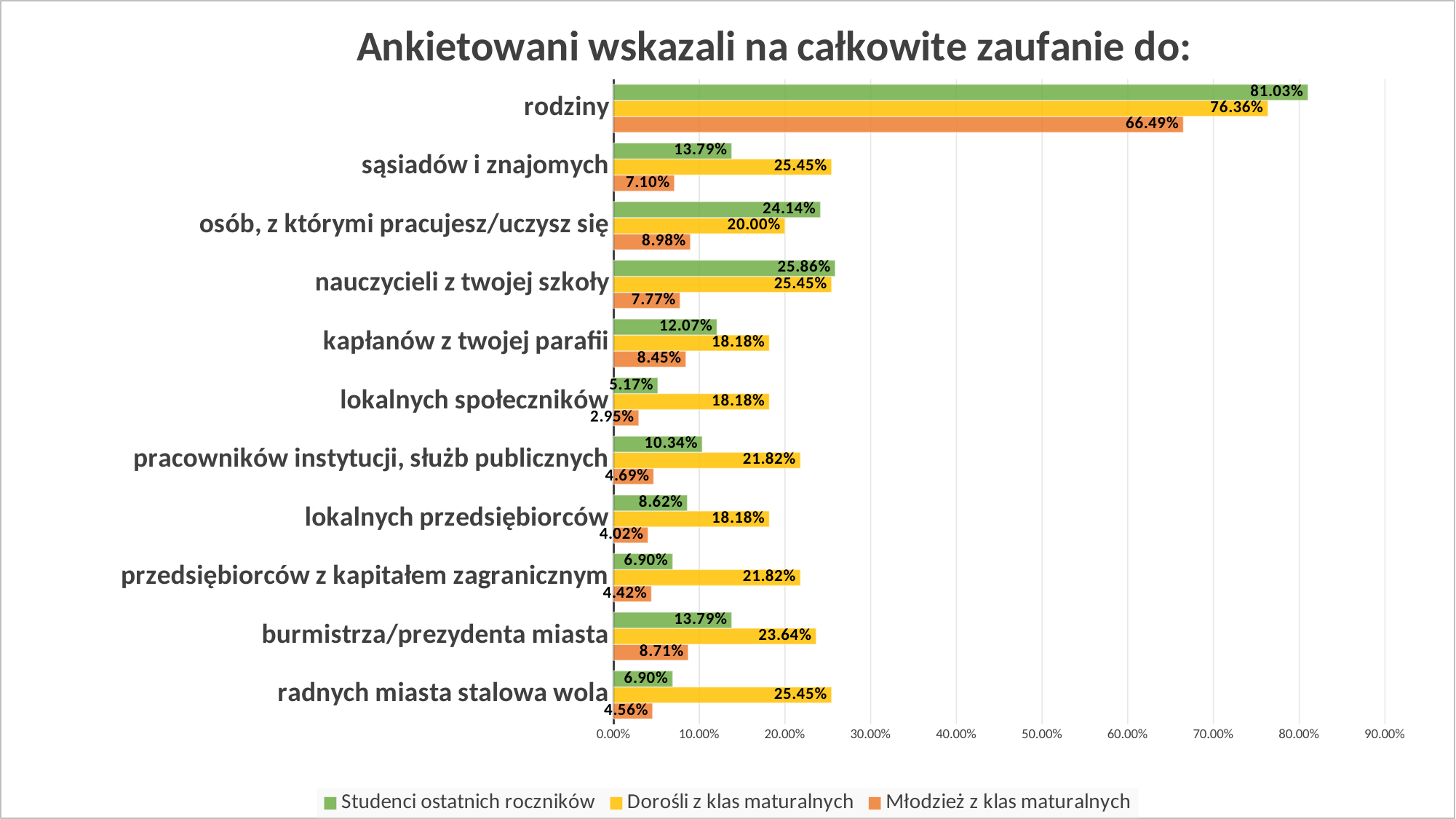
For 'osób, z którymi pracujesz/uczysz się', which series has the larger value: 'Studenci ostatnich roczników' or 'Dorośli z klas maturalnych'? Studenci ostatnich roczników What is the difference between the 'Studenci ostatnich roczników' and 'Młodzież z klas maturalnych' values for 'rodziny'? 14.54% Which category has the highest value in the 'Młodzież z klas maturalnych' series? rodziny What is the title of the chart? Ankietowani wskazali na całkowite zaufanie do: What is the value for 'rodziny' in the 'Studenci ostatnich roczników' series? 81.03% What type of chart is shown on the slide? bar chart Which category has the lowest value in the 'Studenci ostatnich roczników' series? lokalnych społeczników How many categories are shown on the chart? 11 How many series does the legend list? 3 Is the 'Dorośli z klas maturalnych' value for 'rodziny' greater or less than 70.00%? greater What is the value for 'lokalnych społeczników' in the 'Młodzież z klas maturalnych' series? 2.95% What is the value for 'burmistrza/prezydenta miasta' in the 'Dorośli z klas maturalnych' series? 23.64%